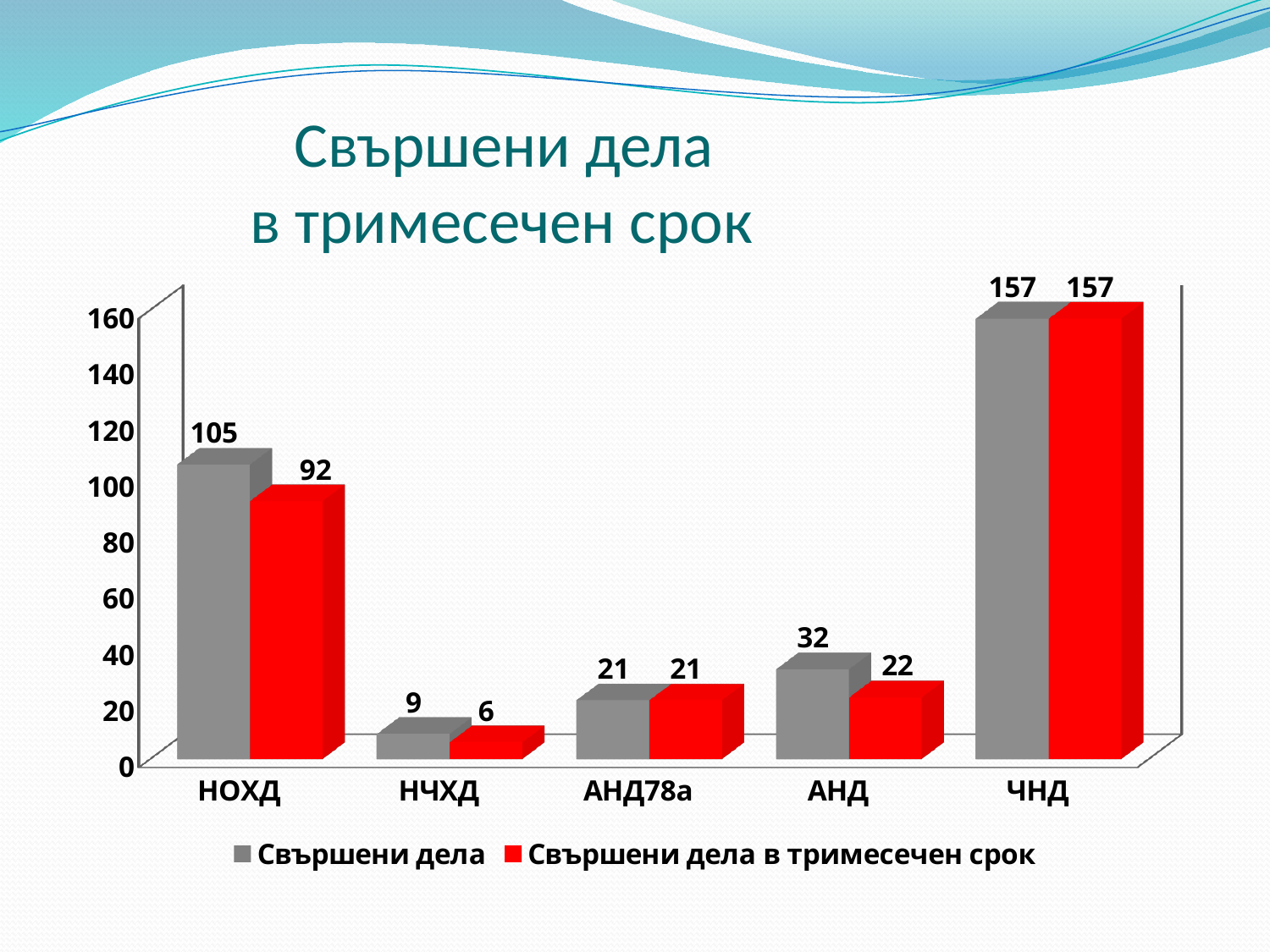
Which category has the lowest value for "Свършени дела в тримесечен срок"? НЧХД What is the value of "Свършени дела в тримесечен срок" for НОХД? 92 What is the value of "Свършени дела в тримесечен срок" for НЧХД? 6 What is the value of "Свършени дела" for АНД? 32 What is the difference between "Свършени дела" and "Свършени дела в тримесечен срок" for НОХД? 13 How many series does the legend list? 2 What is the value of "Свършени дела" for НОХД? 105 What kind of chart is shown on the slide? Bar chart Which is larger for НЧХД: "Свършени дела" or "Свършени дела в тримесечен срок"? Свършени дела What is the difference between "Свършени дела" and "Свършени дела в тримесечен срок" for АНД? 10 How many categories are shown on the x axis? 5 Which category has the highest value for "Свършени дела"? ЧНД